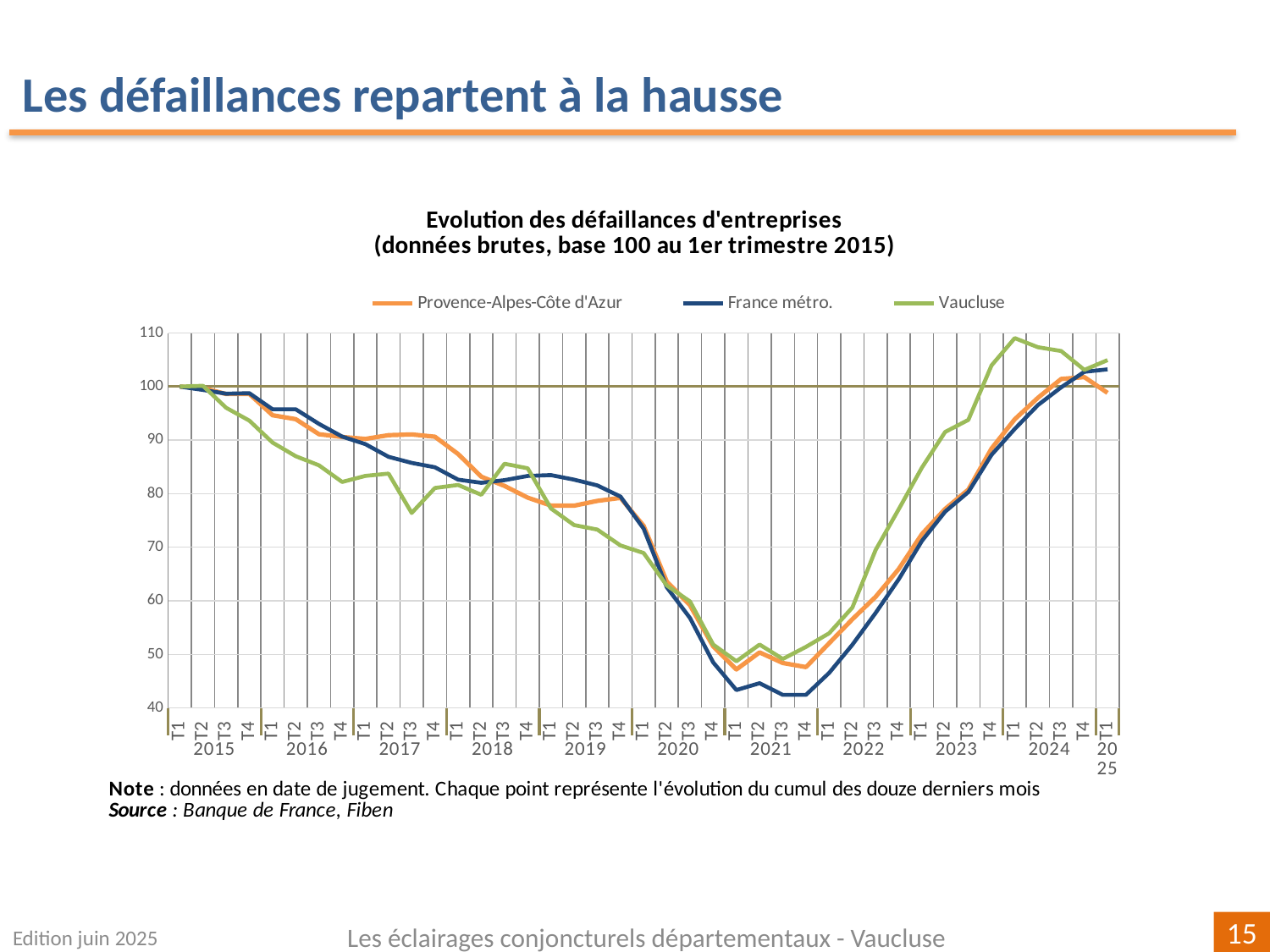
Is the value for France métro. at T1 2021 greater or less than 50? less What is the title of the chart? Evolution des défaillances d'entreprises (données brutes, base 100 au 1er trimestre 2015) Is the value for Vaucluse at T1 2024 greater or less than 100? greater At T4 2021, which series has the lowest value? France métro. Does the Vaucluse series rise or fall between T1 2021 and T1 2024? rise How many series does the legend list? 3 At T3 2017, which is higher: Provence-Alpes-Côte d'Azur or Vaucluse? Provence-Alpes-Côte d'Azur At T1 2024, which series has the highest value? Vaucluse What kind of chart is shown on the slide? line chart Is the value for Vaucluse at T3 2017 greater or less than 80? less What is the value of the France métro. series at T1 2015? 100 Does the France métro. series rise or fall between T1 2015 and T1 2021? fall